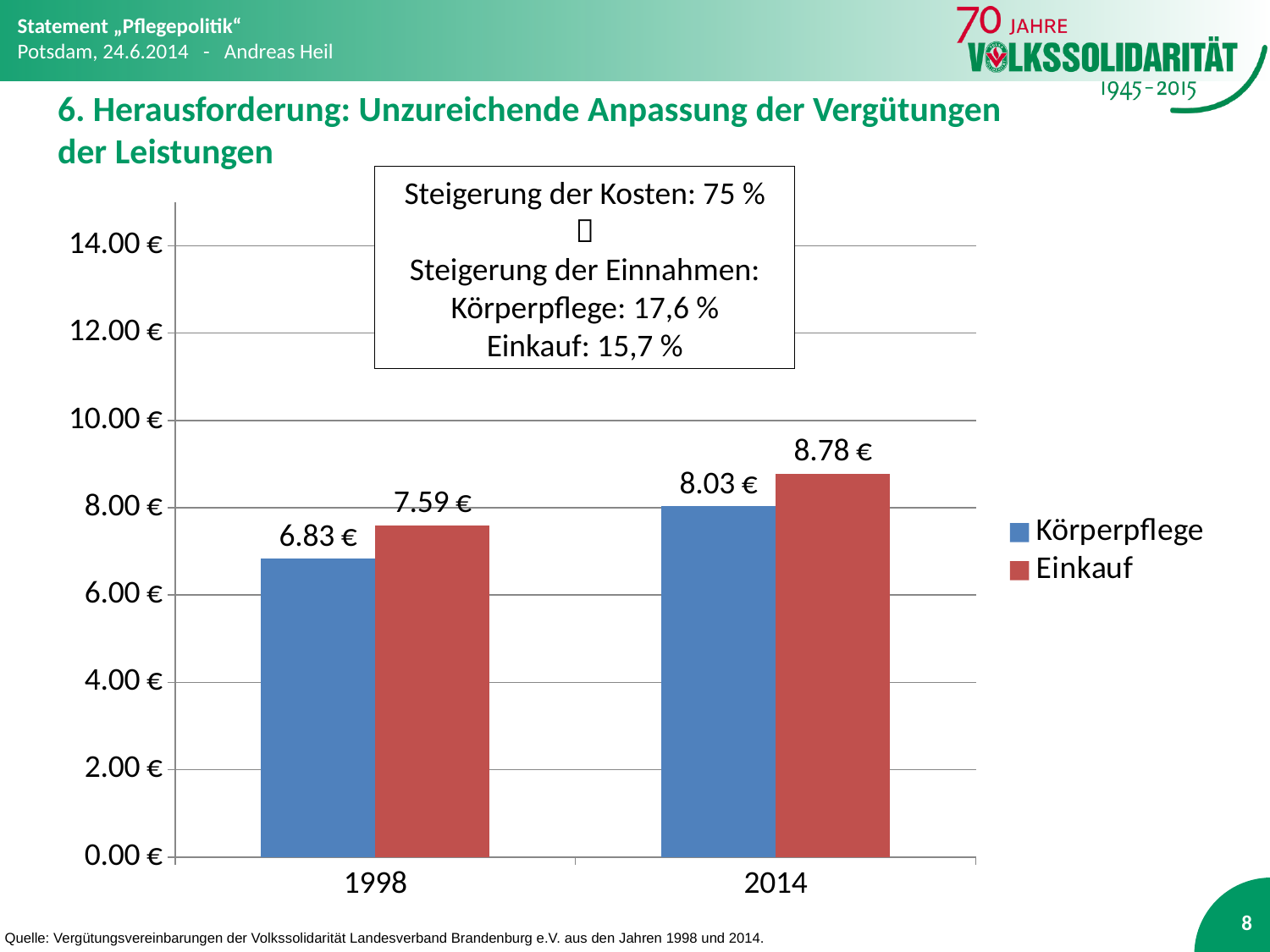
What is the difference between the Einkauf values for 2014 and 1998? 1.19 € What is the value for Körperpflege in 2014? 8.03 € Do the Körperpflege values rise or fall from 1998 to 2014? Rise What is the value for Einkauf in 1998? 7.59 € What kind of chart is shown on the slide? Bar chart What is the value for Körperpflege in 1998? 6.83 € What colour are the Einkauf bars? Red How many series does the legend list? 2 Which is larger: Körperpflege in 2014 or Einkauf in 1998? Körperpflege in 2014 Which series has the highest value in 2014? Einkauf Which bar shows the lowest value on the chart? Körperpflege in 1998 What is the value for Einkauf in 2014? 8.78 €